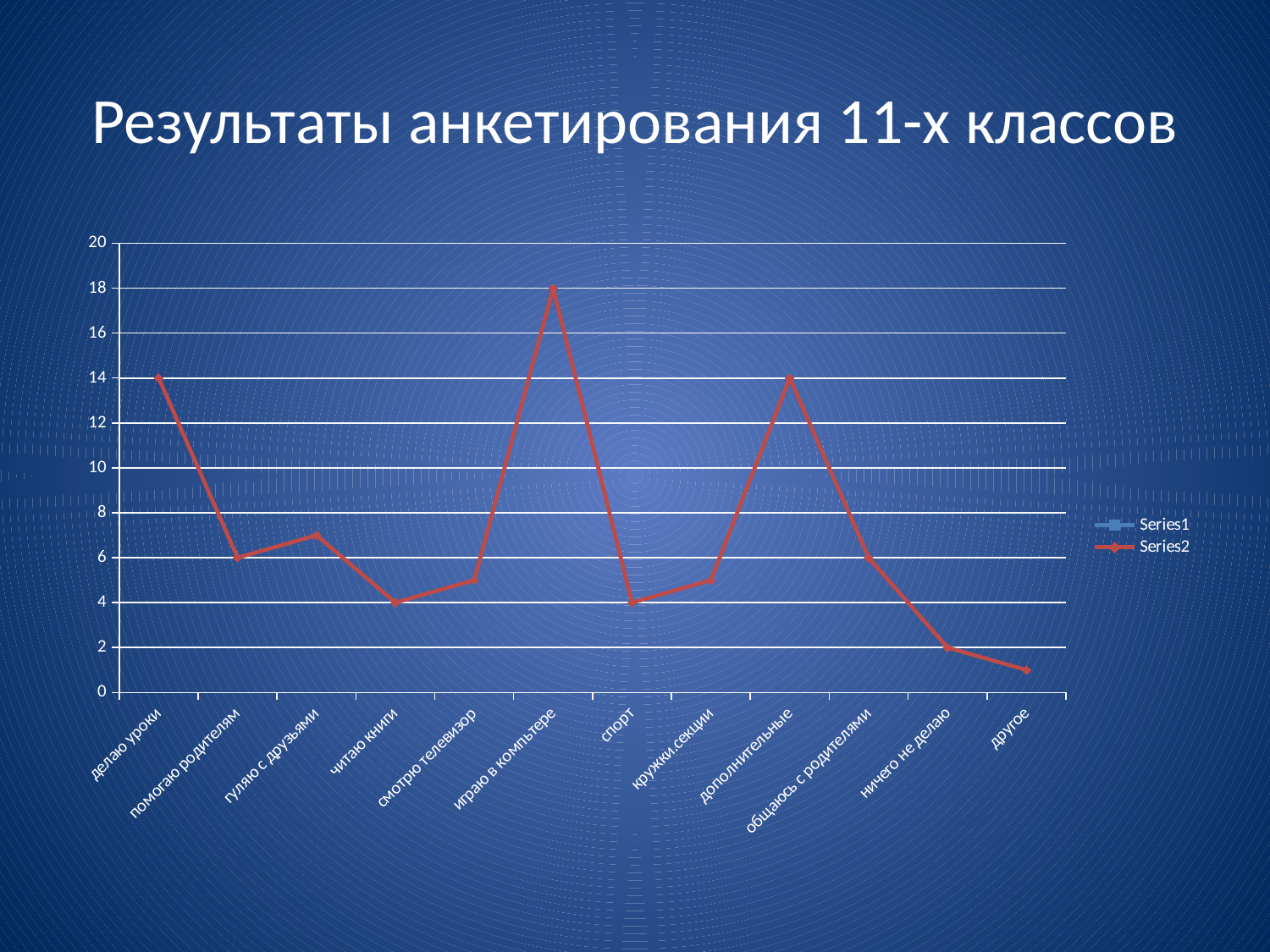
Is the value for "гуляю с друзьями" greater or less than 6? greater What type of chart is shown on the slide? line chart How many categories are shown on the x axis? 12 What is the value for "ничего не делаю"? 2 Which is larger, the value for "делаю уроки" or the value for "помогаю родителям"? делаю уроки What is the value for "играю в компьтере"? 18 What is the value for "дополнительные"? 14 Which category has the lowest value? другое How many series does the legend list? 2 What is the value for "делаю уроки"? 14 What is the difference between the values for "играю в компьтере" and "делаю уроки"? 4 Which category has the highest value? играю в компьтере